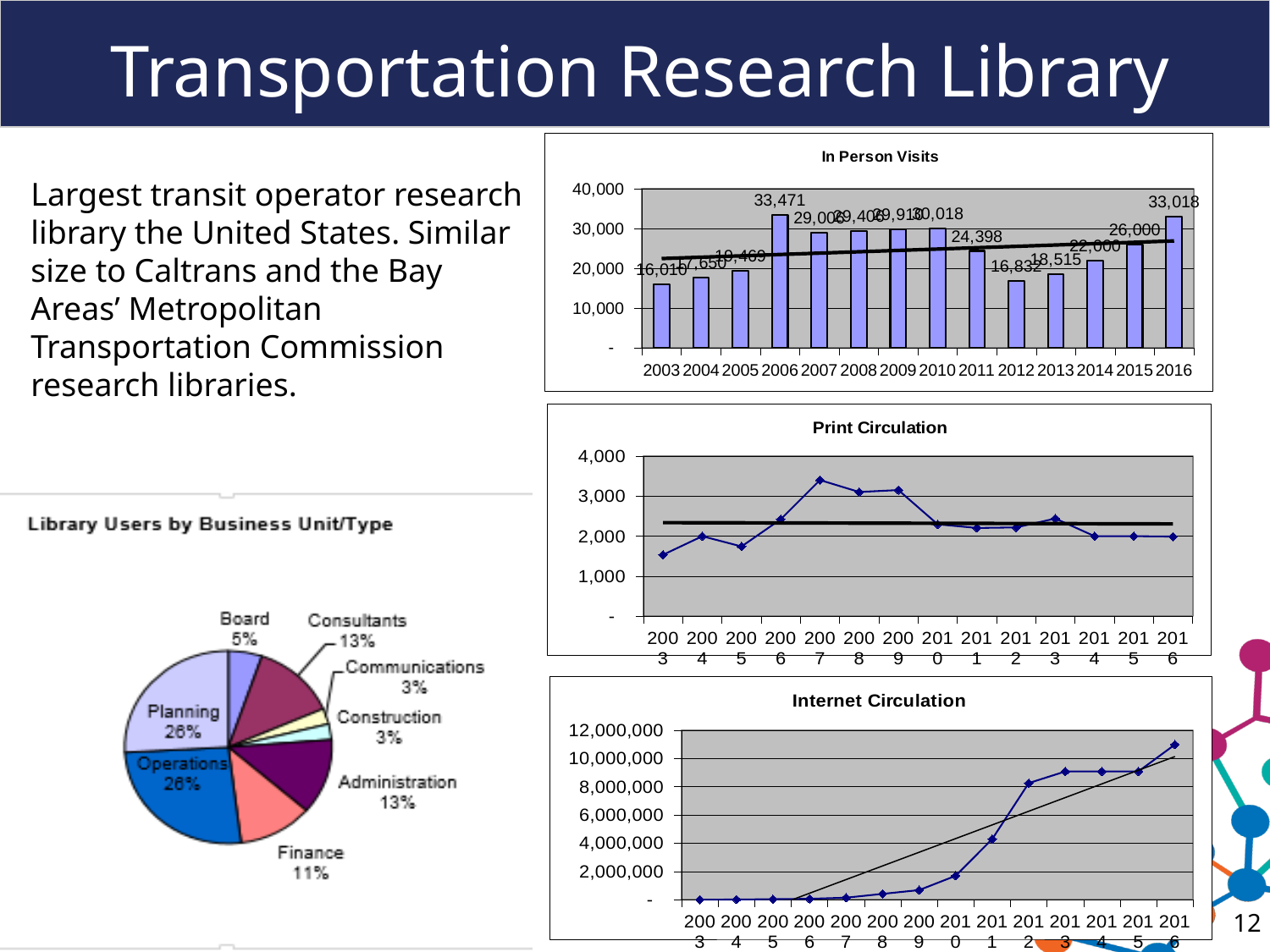
On the Library Users by Business Unit/Type pie chart, how many slices are there? 8 On the Print Circulation chart, is the value for 2007 greater or less than 3,000? greater On the In Person Visits chart, what is the difference between the 2015 and 2014 values? 4,000 On the In Person Visits chart, what is the value for 2006? 33,471 On the In Person Visits chart, which year has the highest number of visits? 2006 On the Print Circulation chart, how many data points are plotted? 14 On the In Person Visits chart, which is larger, the value for 2012 or the value for 2013? 2013 What kind of chart is the In Person Visits chart? bar chart On the In Person Visits chart, what is the value for 2011? 24,398 On the In Person Visits chart, what is the value for 2016? 33,018 On the Internet Circulation chart, is the value for 2016 greater or less than 10,000,000? greater On the Library Users by Business Unit/Type pie chart, what share do Consultants represent? 13%